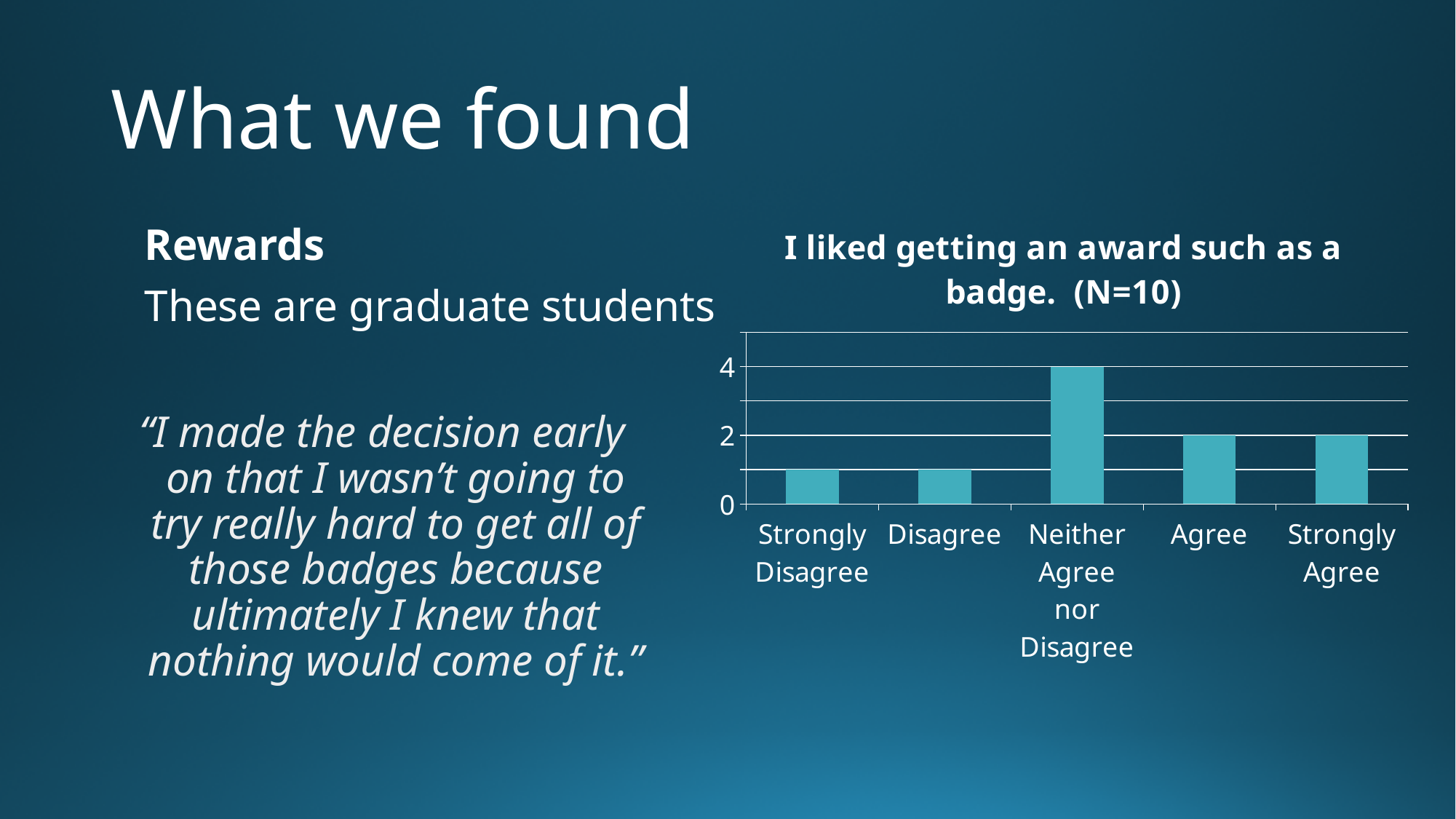
Is the value for Disagree greater or less than 2? less What is the highest value labelled on the vertical axis of the chart? 4 Which response category has the highest bar? Neither Agree nor Disagree Which is larger, the value for Neither Agree nor Disagree or the value for Agree? Neither Agree nor Disagree Is the value for Strongly Disagree greater or less than 2? less What is the difference between the value for Neither Agree nor Disagree and the value for Strongly Agree? 2 How many response categories are shown on the x axis of the chart? 5 What is the value for Neither Agree nor Disagree? 4 What is the value for Strongly Agree? 2 What is the title of the chart? I liked getting an award such as a badge. (N=10) What is the value for Agree? 2 What kind of chart is shown on the slide? bar chart